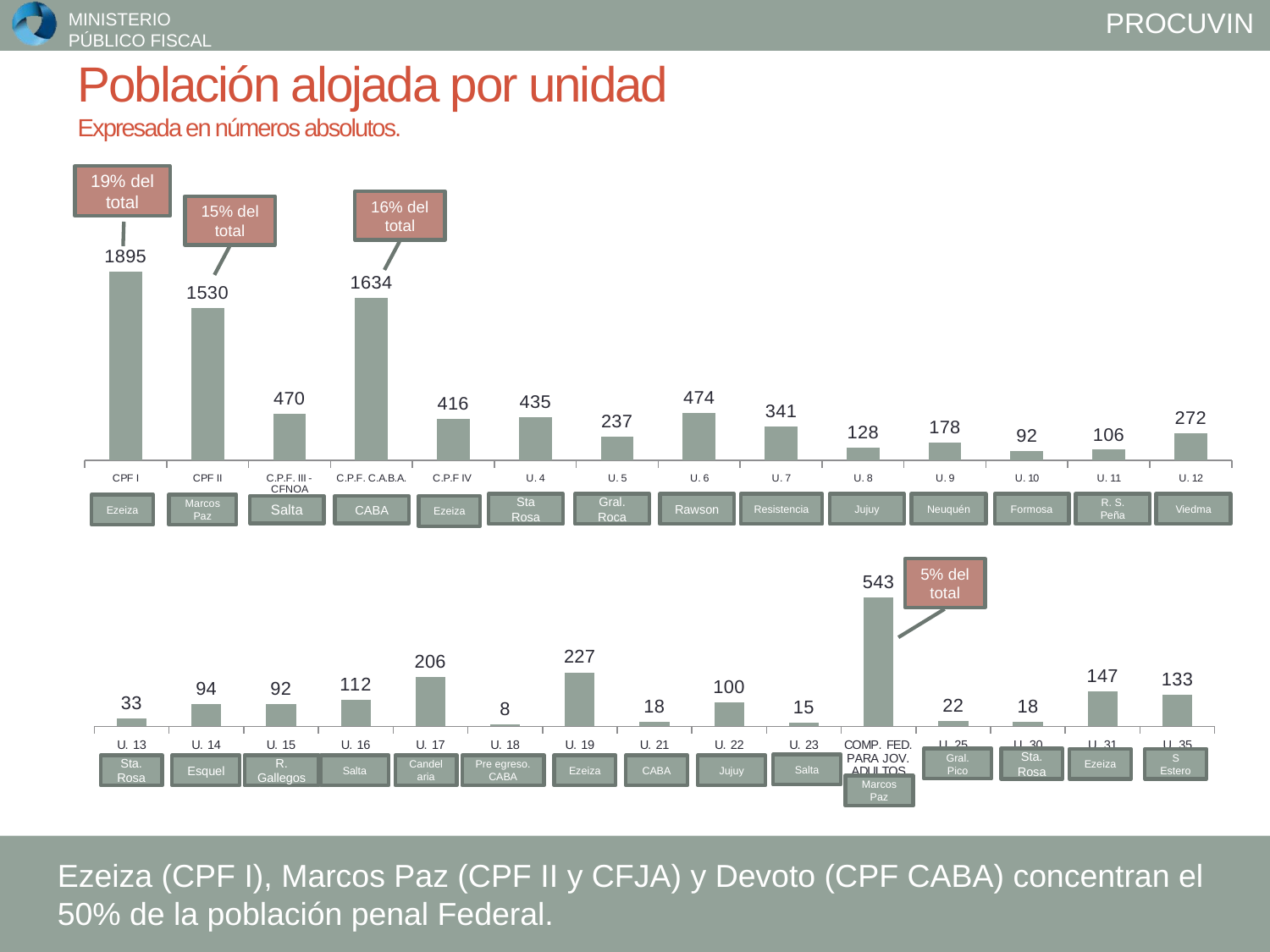
What type of chart is the top chart? Bar chart In the top chart, which unit has the lowest value? U. 10 In the bottom chart, what is the difference between the values for U. 19 and U. 17? 21 In the top chart, what is the difference between the values for CPF I and CPF II? 365 In the top chart, which is larger, the value for U. 4 or the value for U. 7? U. 4 How many units are shown in the top chart? 14 In the top chart, which unit has the highest value? CPF I In the top chart, what is the value for U. 6? 474 In the bottom chart, which unit has the lowest value? U. 18 In the bottom chart, what is the value for COMP. FED. PARA JOV. ADULTOS? 543 How many units are shown in the bottom chart? 15 In the top chart, what is the value for CPF I? 1895